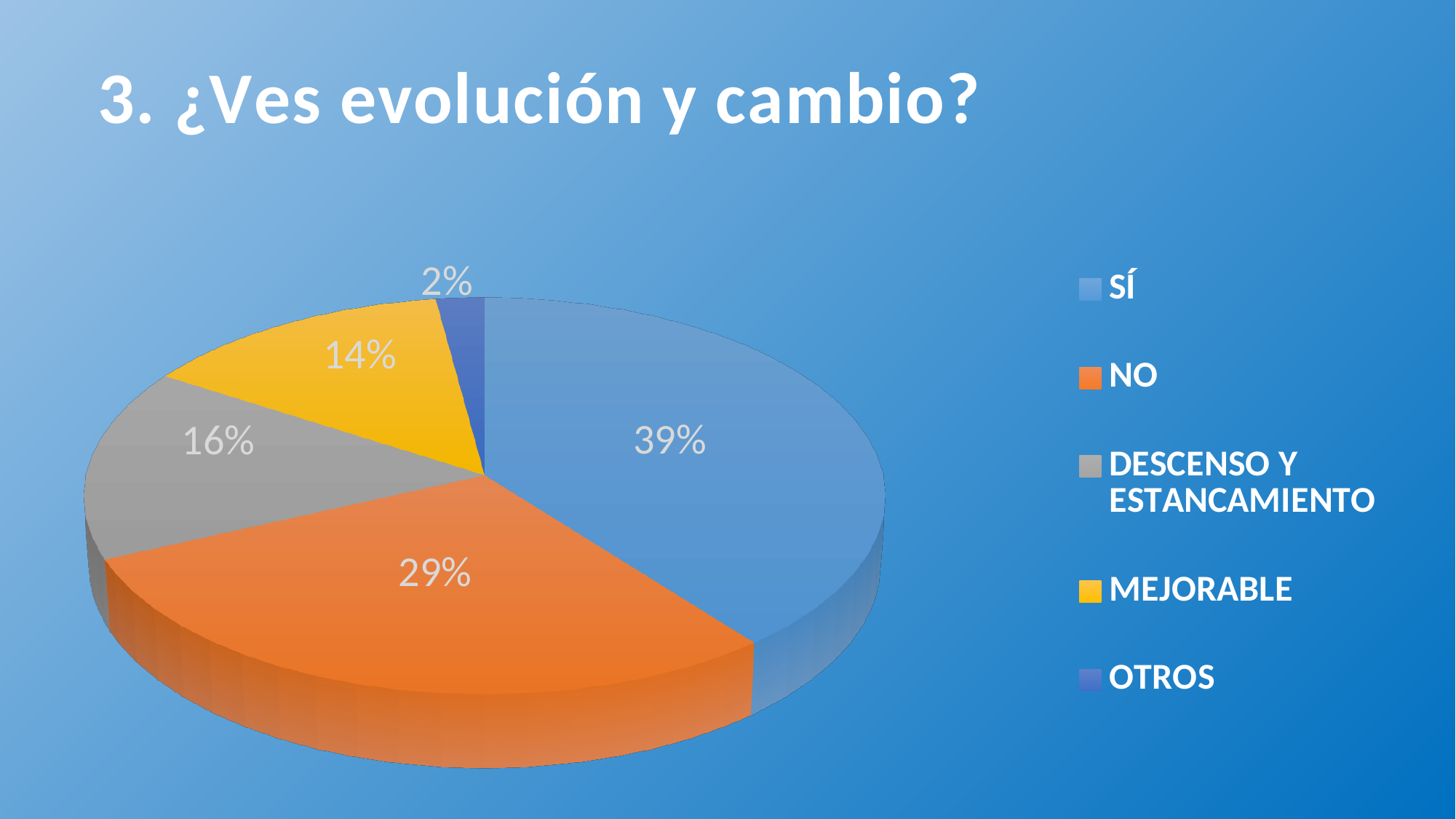
How many categories does the pie chart show? 5 Which category has the largest share of the pie chart? SÍ What percentage of the pie chart corresponds to OTROS? 2% Which category has the smallest share of the pie chart? OTROS What is the difference in percentage points between SÍ and NO? 10 What percentage of the pie chart corresponds to MEJORABLE? 14% What percentage of the pie chart corresponds to DESCENSO Y ESTANCAMIENTO? 16% Which is larger, the share for DESCENSO Y ESTANCAMIENTO or the share for MEJORABLE? DESCENSO Y ESTANCAMIENTO What percentage of the pie chart corresponds to SÍ? 39% What colour is the slice for MEJORABLE? Yellow What kind of chart is shown on the slide? Pie chart What percentage of the pie chart corresponds to NO? 29%